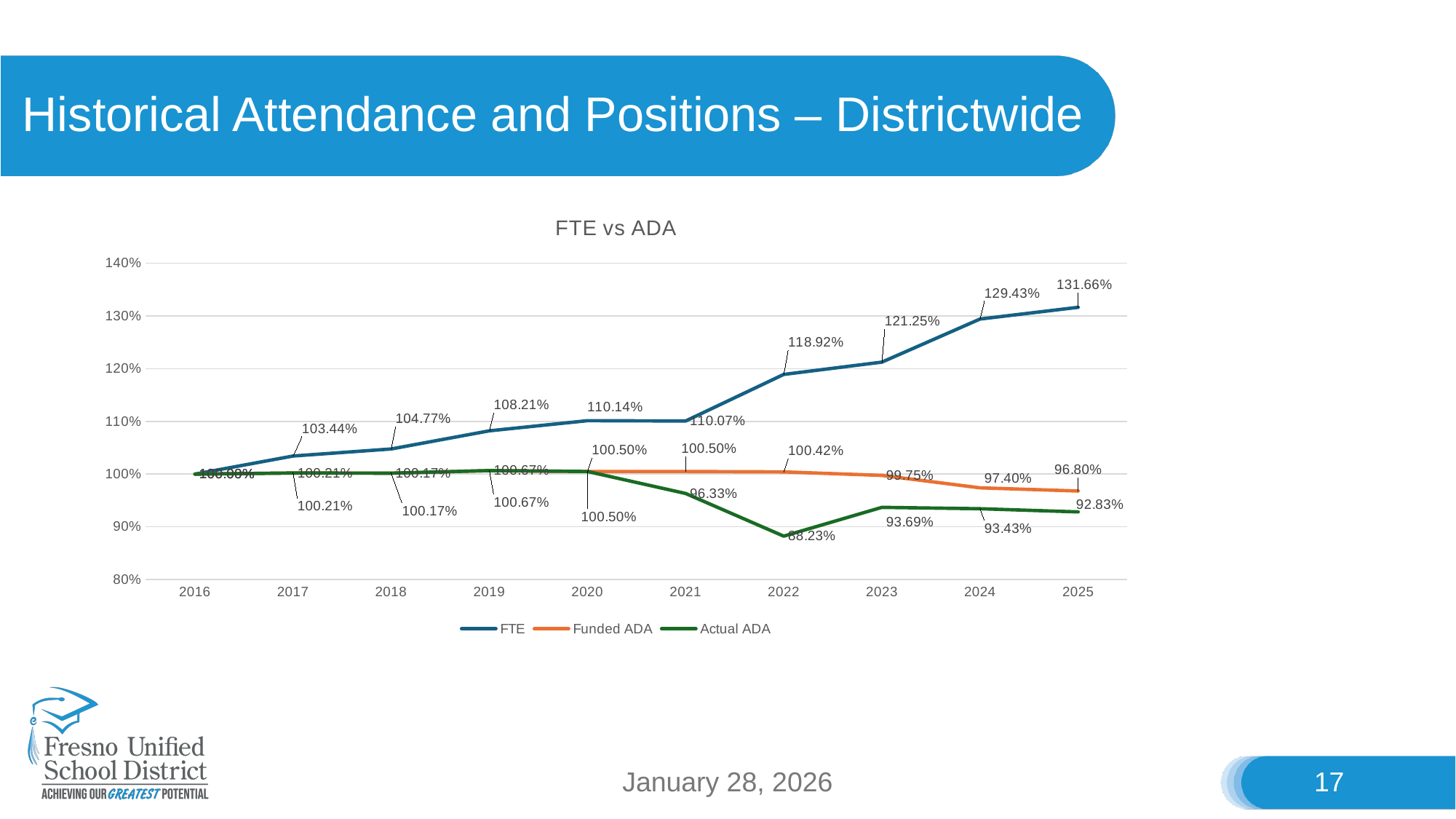
What is the difference between the FTE value and the Actual ADA value in 2025? 38.83% How many series does the legend list? 3 What is the FTE value for 2019? 108.21% How many years are shown on the x axis? 10 Is the FTE value for 2022 greater or less than 120%? less What is the Actual ADA value for 2022? 88.23% What kind of chart is shown on the slide? line chart In which year is the FTE value highest? 2025 In which year is the Actual ADA value lowest? 2022 What is the Funded ADA value for 2024? 97.40% Which is larger in 2023, the Funded ADA value or the Actual ADA value? Funded ADA What is the FTE value for 2025? 131.66%